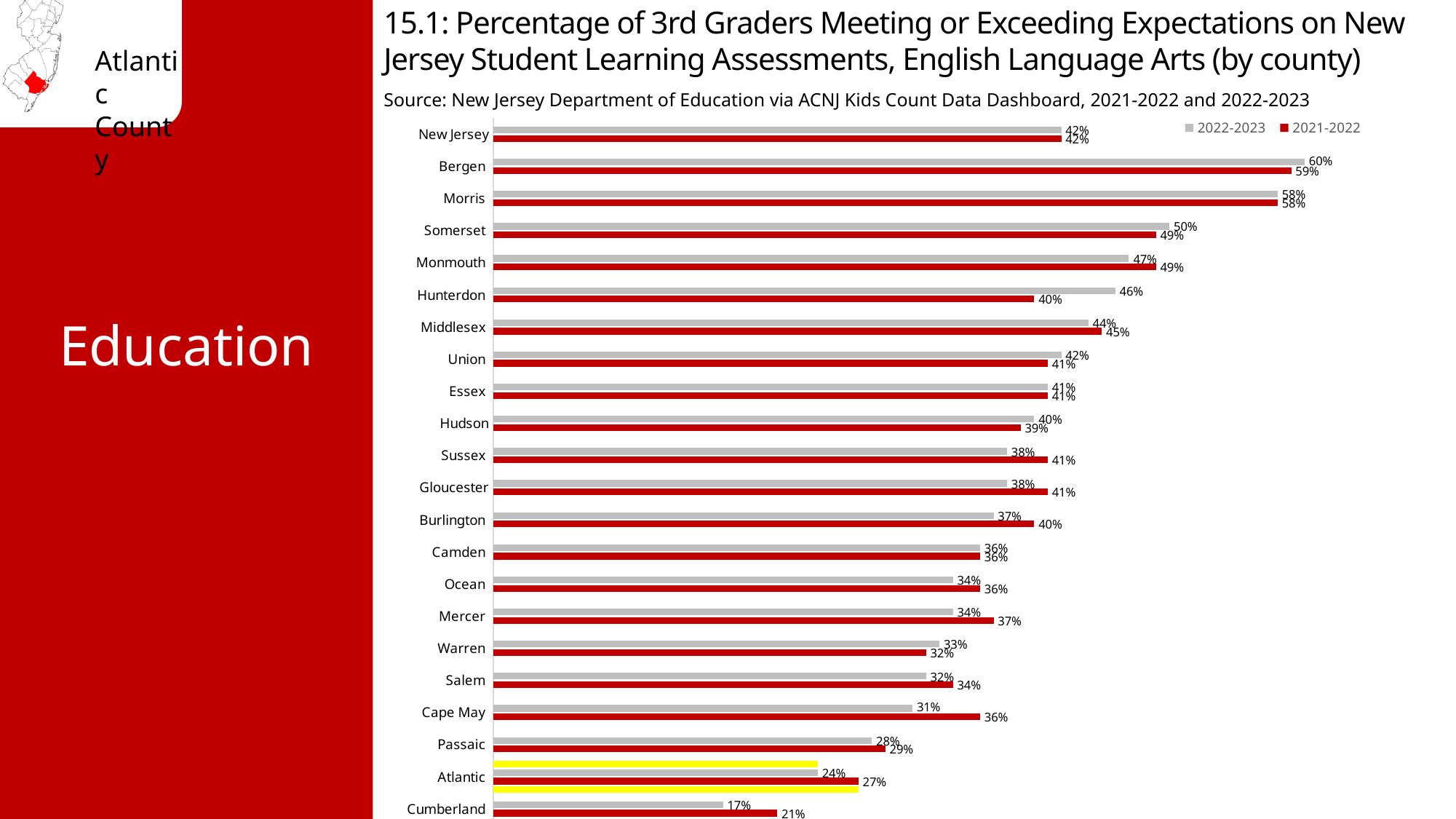
What is the difference between the 2021-2022 and 2022-2023 values for Cape May? 5% What is the difference between the 2022-2023 and 2021-2022 values for Hunterdon? 6% What is the 2022-2023 value for Cape May? 31% What is the 2022-2023 value for Atlantic? 24% What kind of chart is shown on the slide? Bar chart How many series does the legend list? 2 What is the 2021-2022 value for Hunterdon? 40% Which is larger: the 2022-2023 value for Monmouth or the 2022-2023 value for Somerset? Somerset Which county has the highest 2022-2023 value? Bergen How many categories (counties plus New Jersey) are shown on the chart? 22 Which county has the lowest 2021-2022 value? Cumberland Which is larger for Atlantic: the 2022-2023 value or the 2021-2022 value? 2021-2022